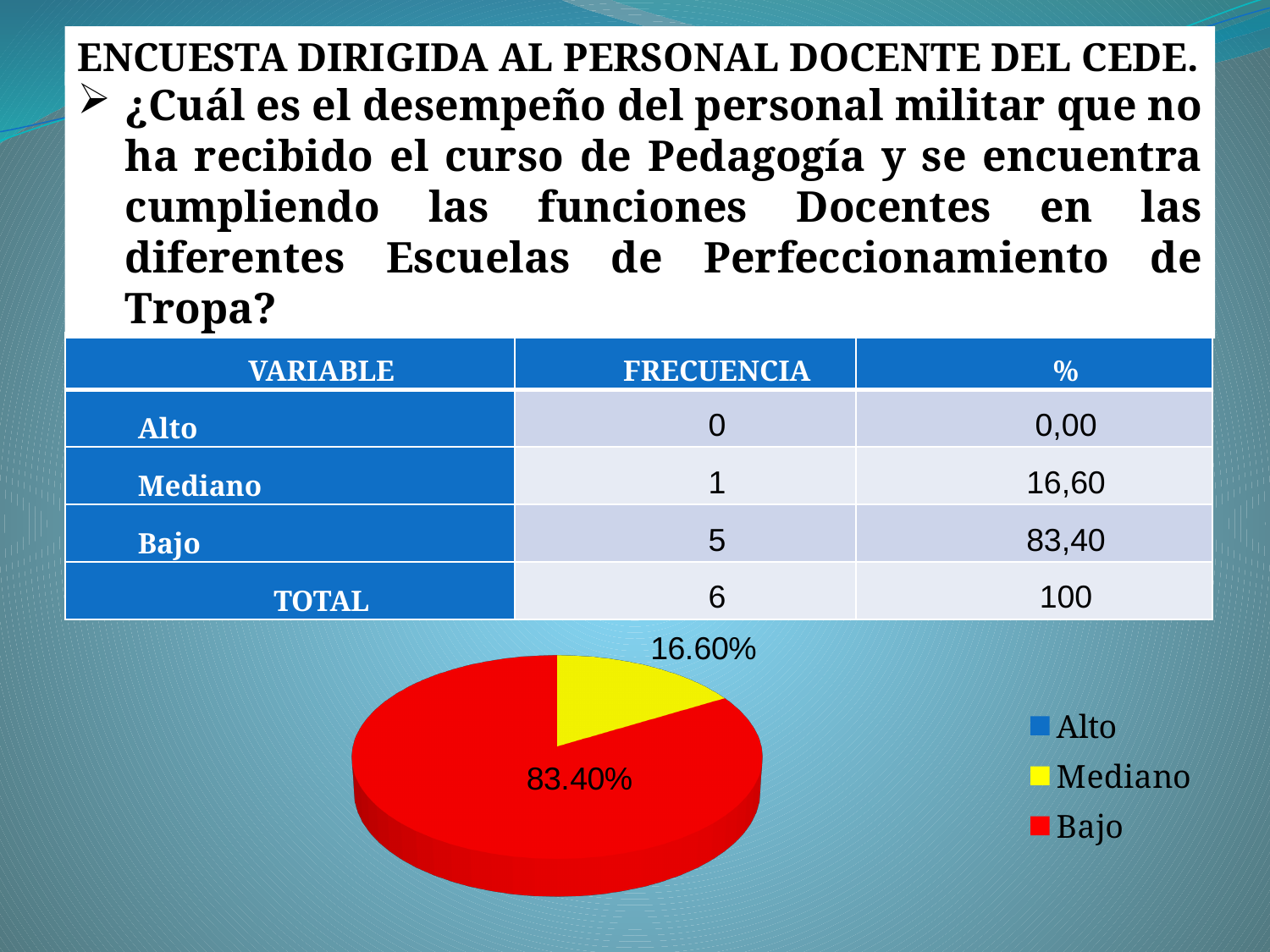
What share of the pie does Mediano represent? 16.60% Which of Mediano or Bajo has the larger slice? Bajo What kind of chart is shown on the slide? pie chart Is the share for Bajo greater or less than 50%? greater Which category has the largest slice of the pie? Bajo What is the difference in percentage points between the Bajo and Mediano slices? 66.80% What colour does the legend assign to Mediano? yellow What colour is the Bajo slice in the pie chart? red How many entries does the legend list? 3 What share of the pie does Bajo represent? 83.40%